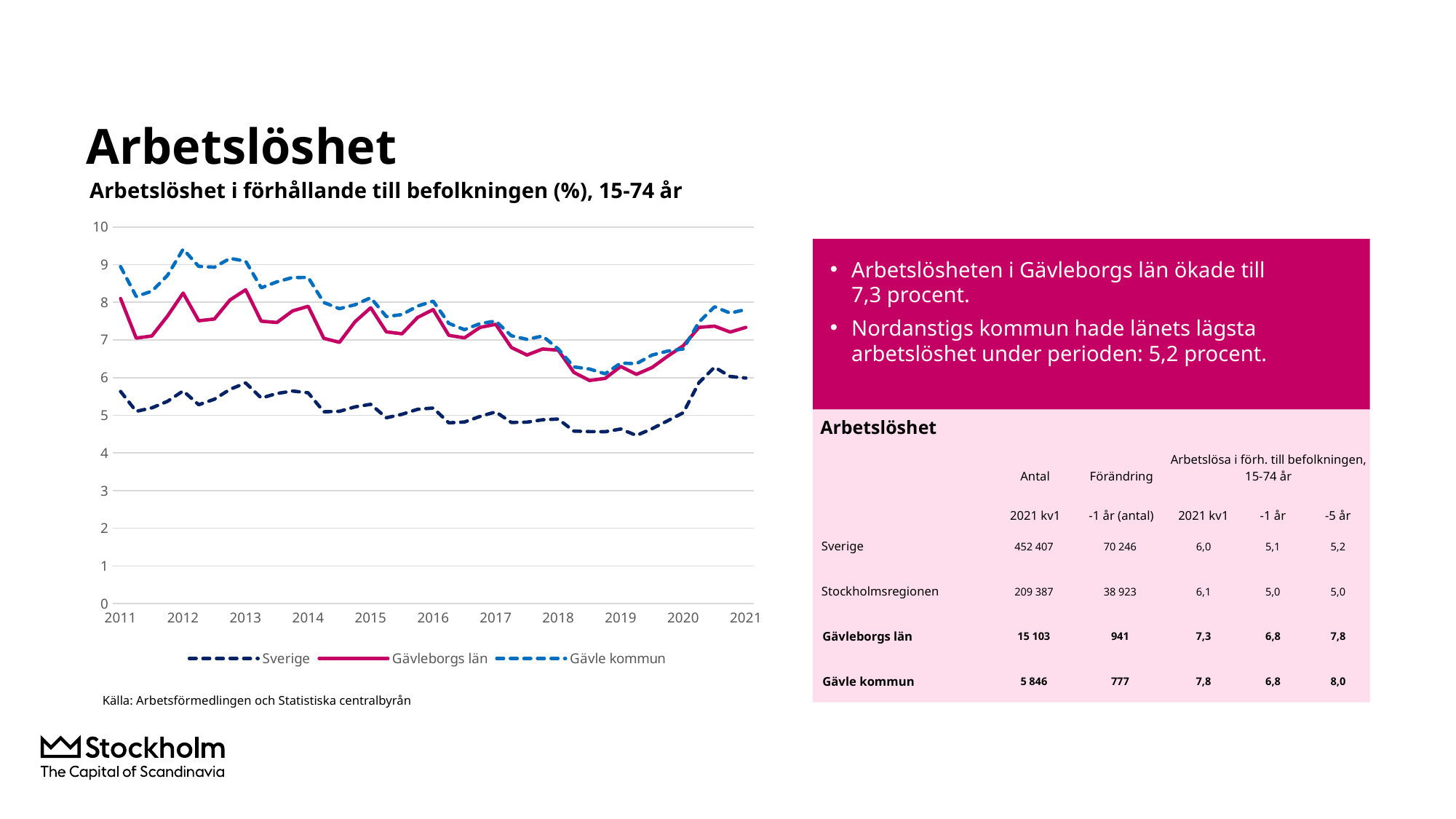
Is the value for Sverige in 2021 greater or less than 5? greater Which series has the lowest values across the whole period? Sverige How many years are labelled on the x axis? 11 What is the title of the chart? Arbetslöshet i förhållande till befolkningen (%), 15-74 år How many series does the chart legend list? 3 Is the value for Gävleborgs län in 2013 greater or less than 7? greater Does the Gävle kommun line generally rise or fall from 2012 to 2018? fall Which series are listed in the chart legend? Sverige, Gävleborgs län, Gävle kommun What kind of chart is shown on the slide? line chart Is the value for Gävle kommun in 2012 greater or less than 9? greater In 2011, which series has the higher value, Sverige or Gävle kommun? Gävle kommun